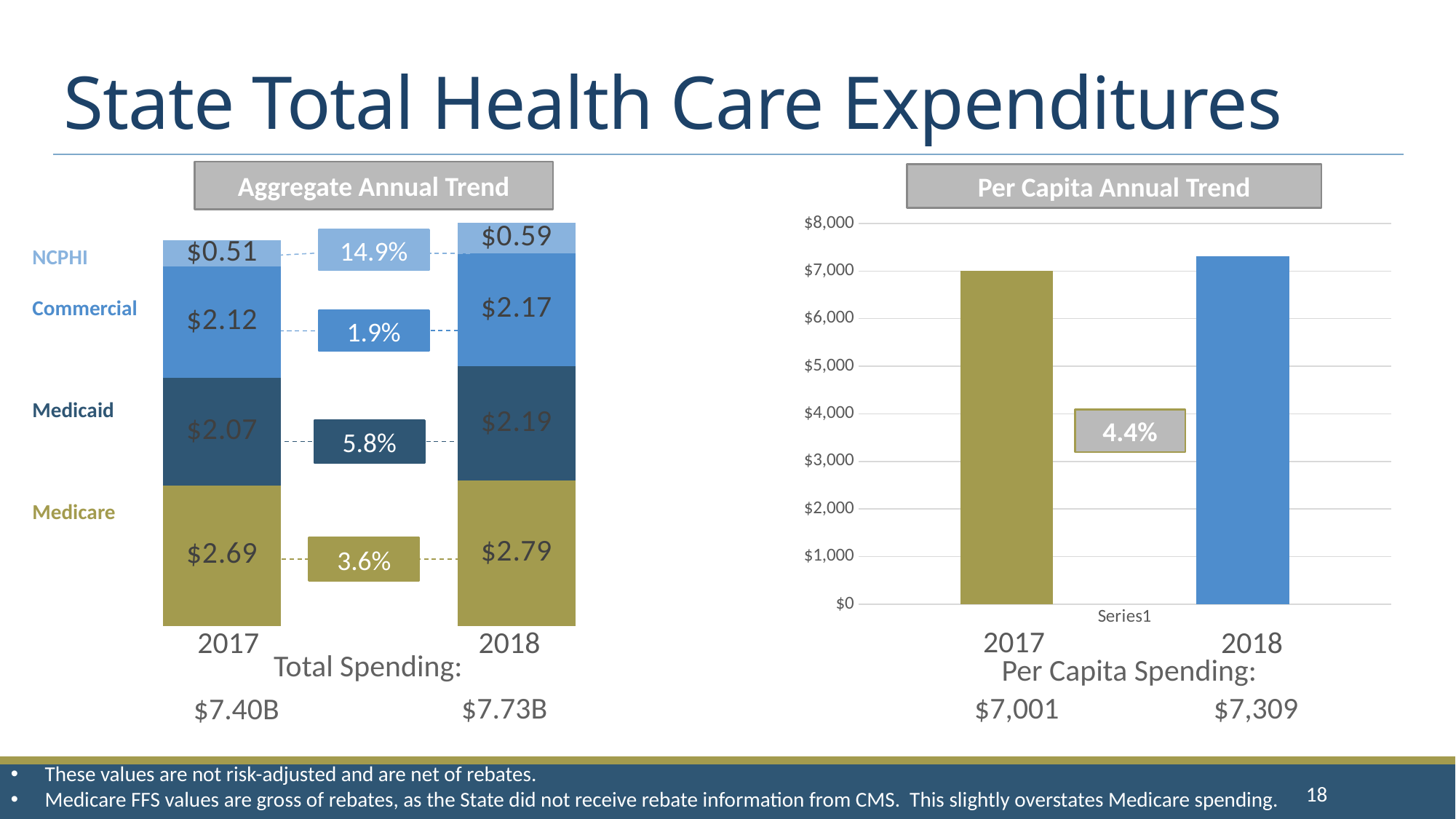
In the Aggregate Annual Trend chart, what is the total spending shown for 2018? $7.73B In the Aggregate Annual Trend chart, what is the Medicaid value for 2018? $2.19 In the Aggregate Annual Trend chart, what percentage growth is shown for Commercial between 2017 and 2018? 1.9% In the Aggregate Annual Trend chart, what is the NCPHI value for 2018? $0.59 In the Aggregate Annual Trend chart, which segment has the smallest value in 2017? NCPHI In the Aggregate Annual Trend chart, which segment has the largest value in 2018? Medicare In the Per Capita Annual Trend chart, is the value for 2017 greater or less than $6,000? greater In the Aggregate Annual Trend chart, what is the difference between the Medicare values for 2018 and 2017? $0.10 In the Per Capita Annual Trend chart, what is the per capita spending for 2018? $7,309 What kind of chart is the Aggregate Annual Trend chart? Stacked bar chart In the Aggregate Annual Trend chart, how many segments make up each stacked bar? 4 In the Aggregate Annual Trend chart, what is the Medicare value for 2017? $2.69